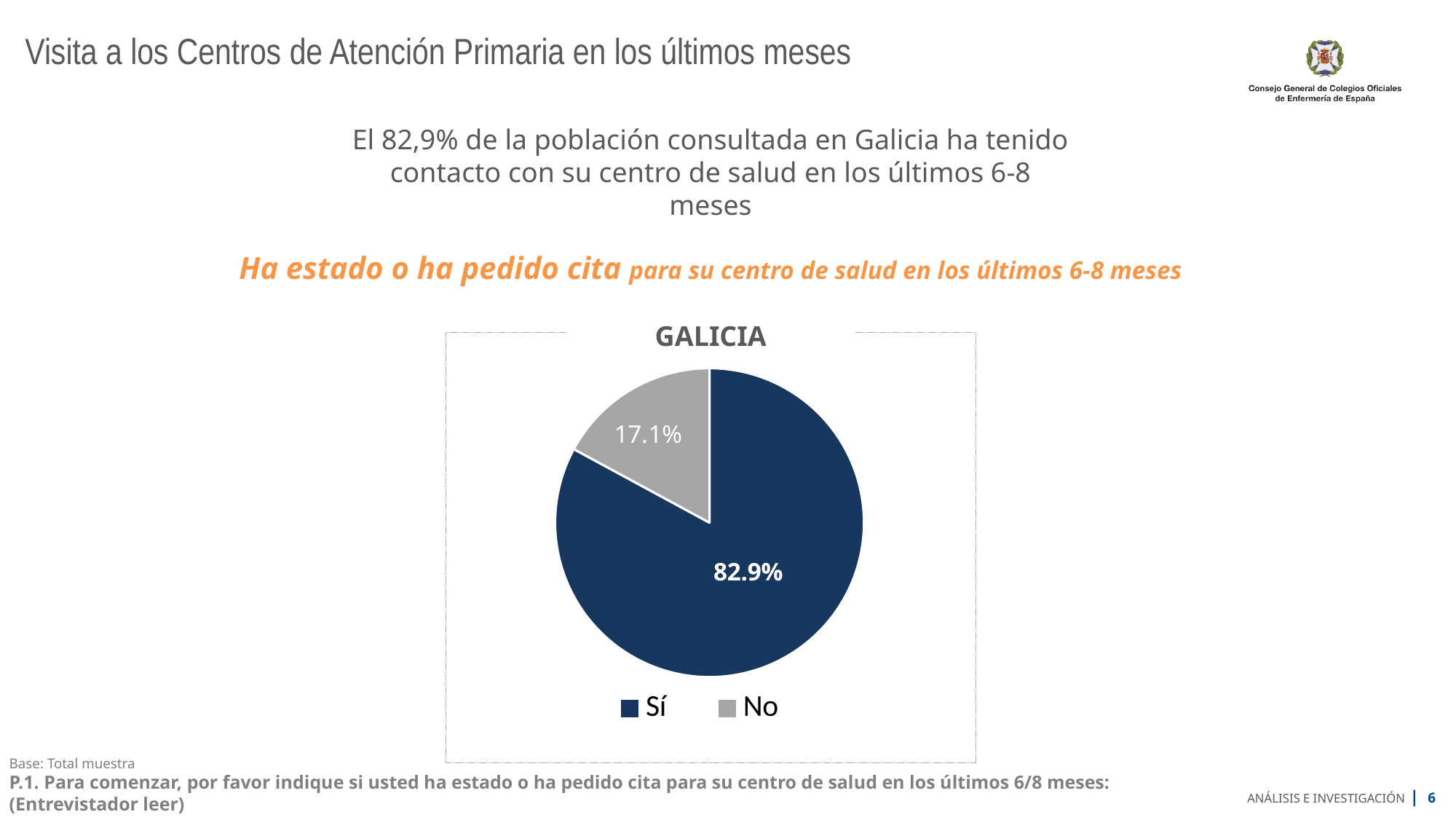
Which is larger, the "Sí" slice or the "No" slice? Sí What percentage of respondents answered "Sí"? 82.9% How many slices does the pie chart have? 2 What is the title of the chart? GALICIA Which category has the smallest share of the pie? No What is the total of the two slices shown in the pie chart? 100% What is the difference in percentage points between the "Sí" and "No" slices? 65.8 What colour is the "No" slice? grey What kind of chart is shown on the slide? pie chart Which category has the largest share of the pie? Sí What percentage of respondents answered "No"? 17.1% How many entries does the legend list? 2